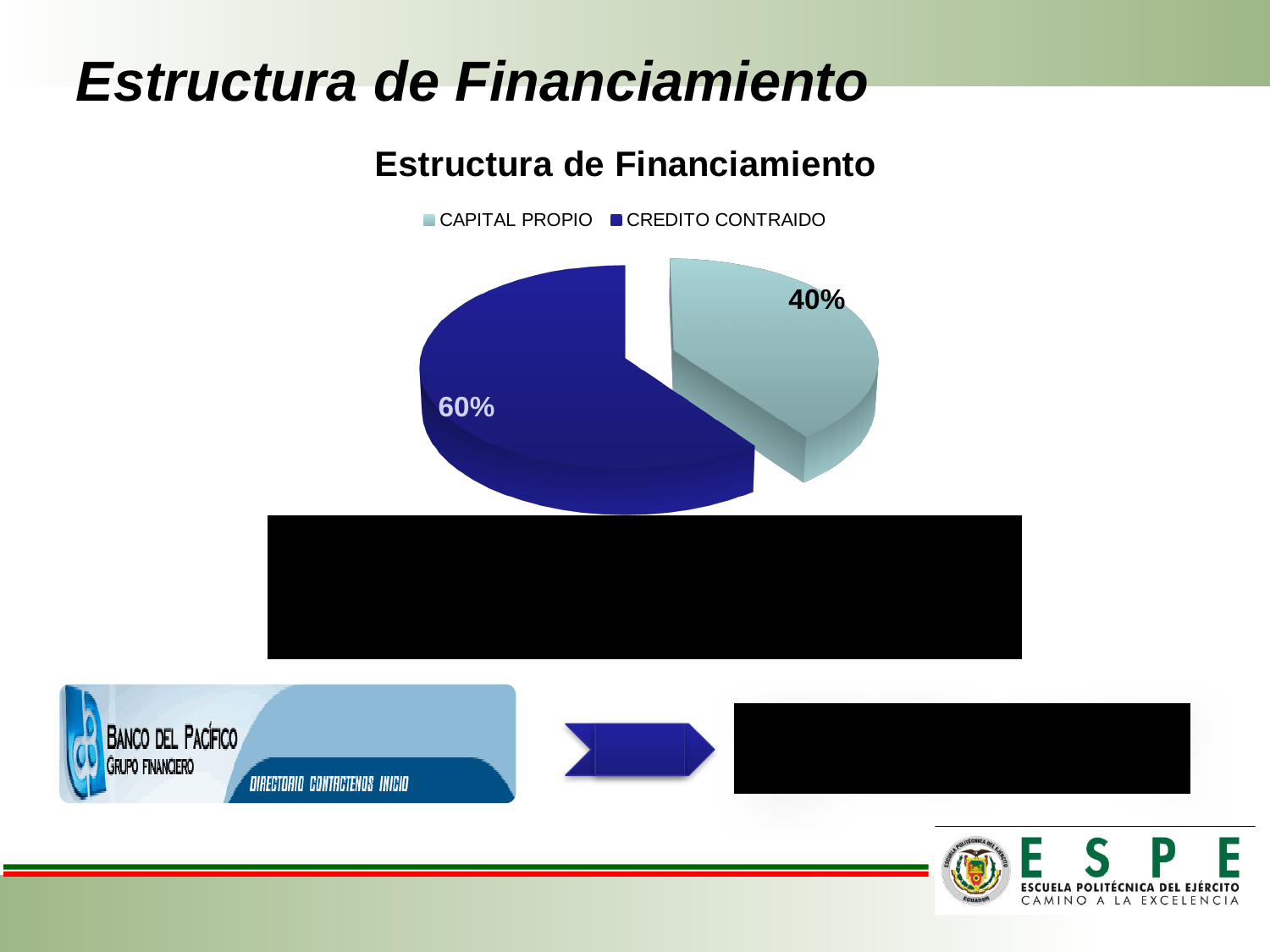
Which category has the smallest slice of the pie? CAPITAL PROPIO How many entries does the legend list? 2 What share of the pie does CREDITO CONTRAIDO represent? 60% Which category has the largest slice of the pie? CREDITO CONTRAIDO Which is larger, CAPITAL PROPIO or CREDITO CONTRAIDO? CREDITO CONTRAIDO What kind of chart is shown on the slide? Pie chart What is the title of the chart? Estructura de Financiamiento Which legend entry is shown in dark blue? CREDITO CONTRAIDO How many slices does the pie chart have? 2 What share of the pie does CAPITAL PROPIO represent? 40% What is the difference in percentage points between CREDITO CONTRAIDO and CAPITAL PROPIO? 20%